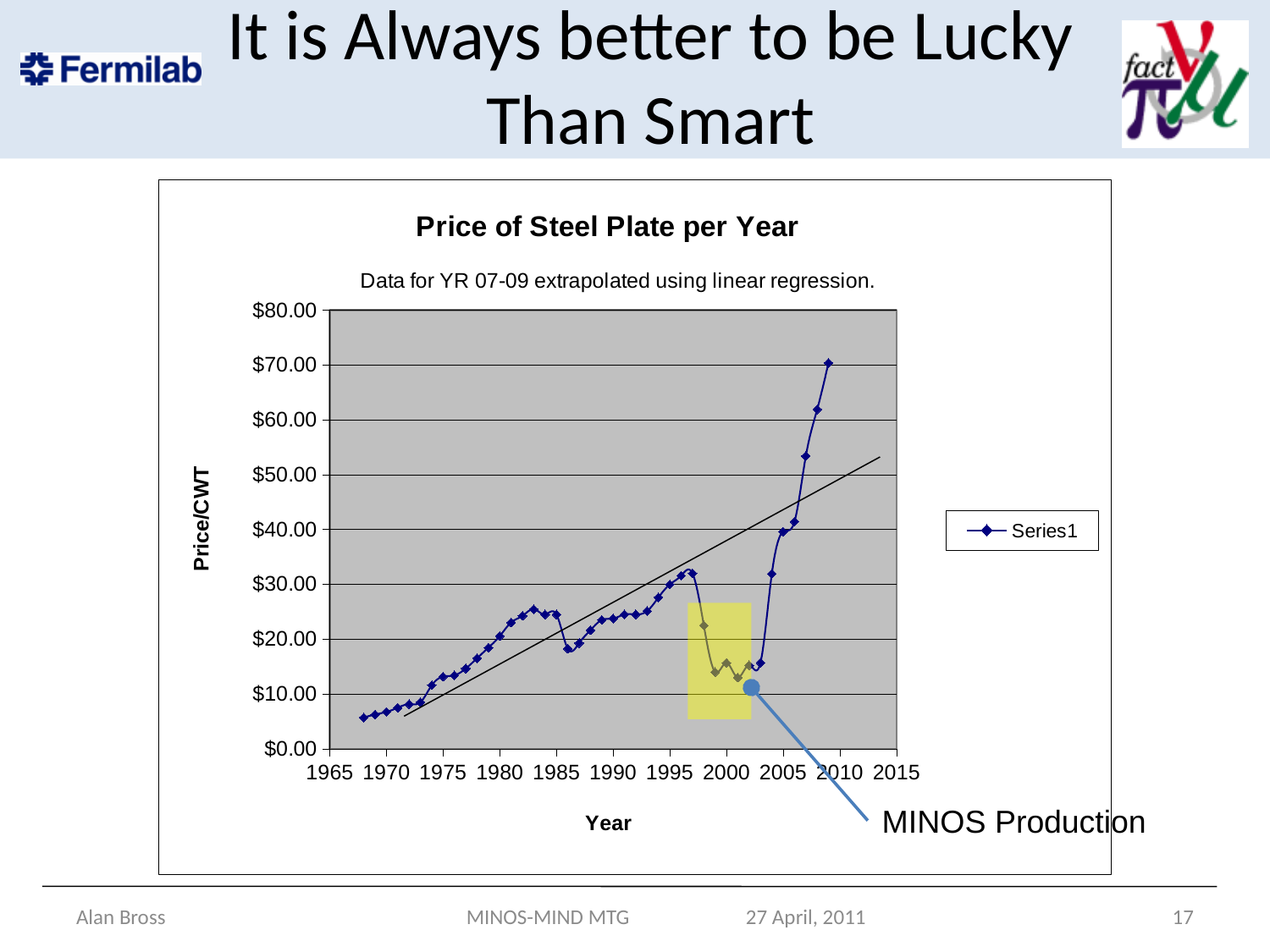
Is the value for the year 1970 greater or less than $10.00? less Overall, does the price of steel plate rise or fall from 1965 to 2010? rise What is the label on the vertical axis of the chart? Price/CWT Is the value for the year 1996 greater or less than $40.00? less Is the value for the year 1983 greater or less than $20.00? greater Which is larger, the price in 2009 or the price in 1970? 2009 How many series does the chart legend list? 1 What kind of chart is shown on the slide? line chart What is the title of the chart? Price of Steel Plate per Year